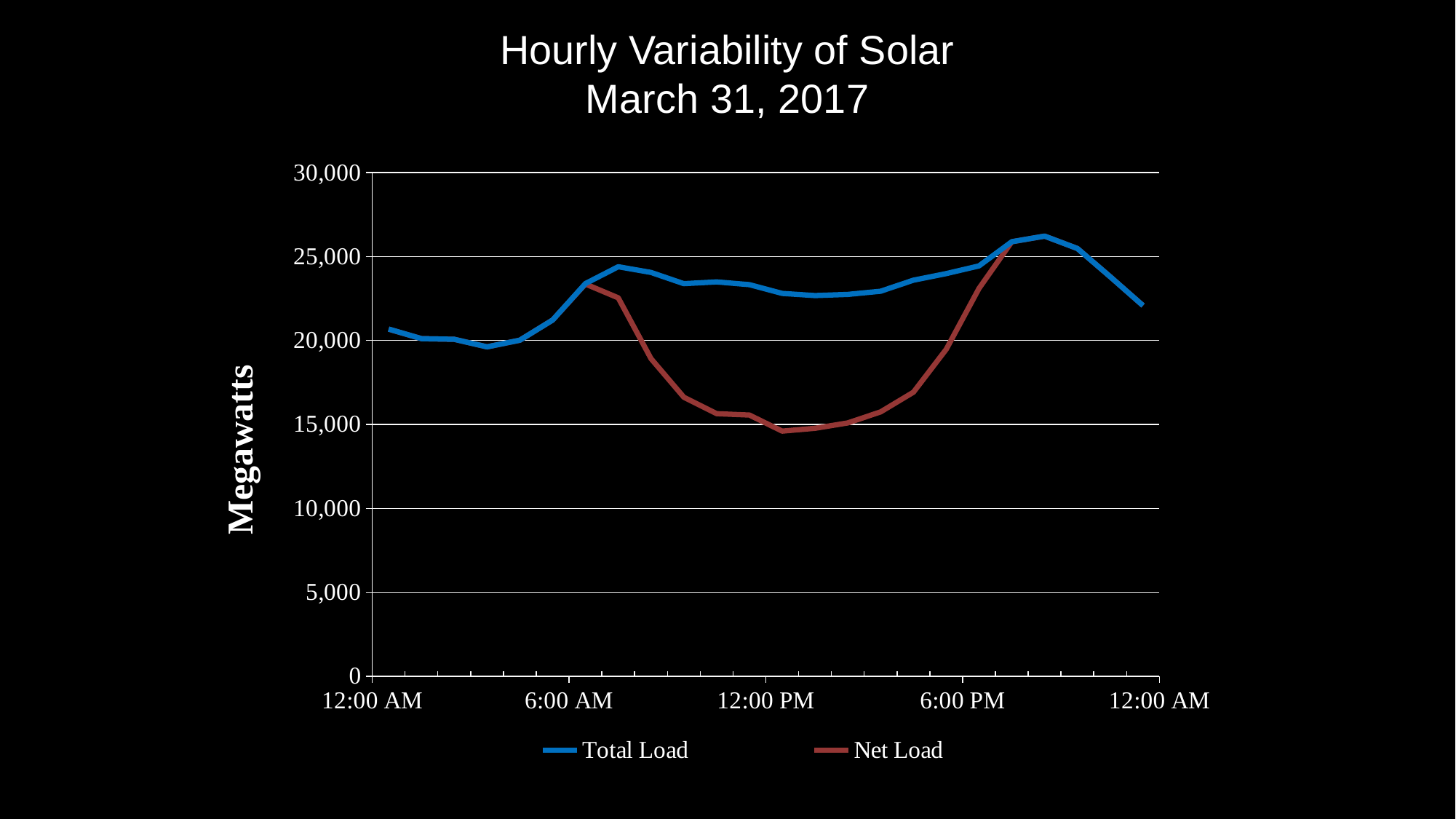
Is the Total Load value at 12:00 PM greater or less than 20,000? greater How many series does the legend list? 2 Does the Total Load line rise or fall between 12:00 PM and 6:00 PM? rise Is the Net Load value at 12:00 PM greater or less than 20,000? less At 12:00 PM, which series has the larger value, Total Load or Net Load? Total Load What is the label on the vertical axis? Megawatts Is the Total Load value at 6:00 AM greater or less than 25,000? less What is the title of the chart? Hourly Variability of Solar March 31, 2017 What kind of chart is shown on the slide? line chart Does the Net Load line rise or fall between 6:00 AM and 12:00 PM? fall Which series reaches the lowest value on the chart? Net Load